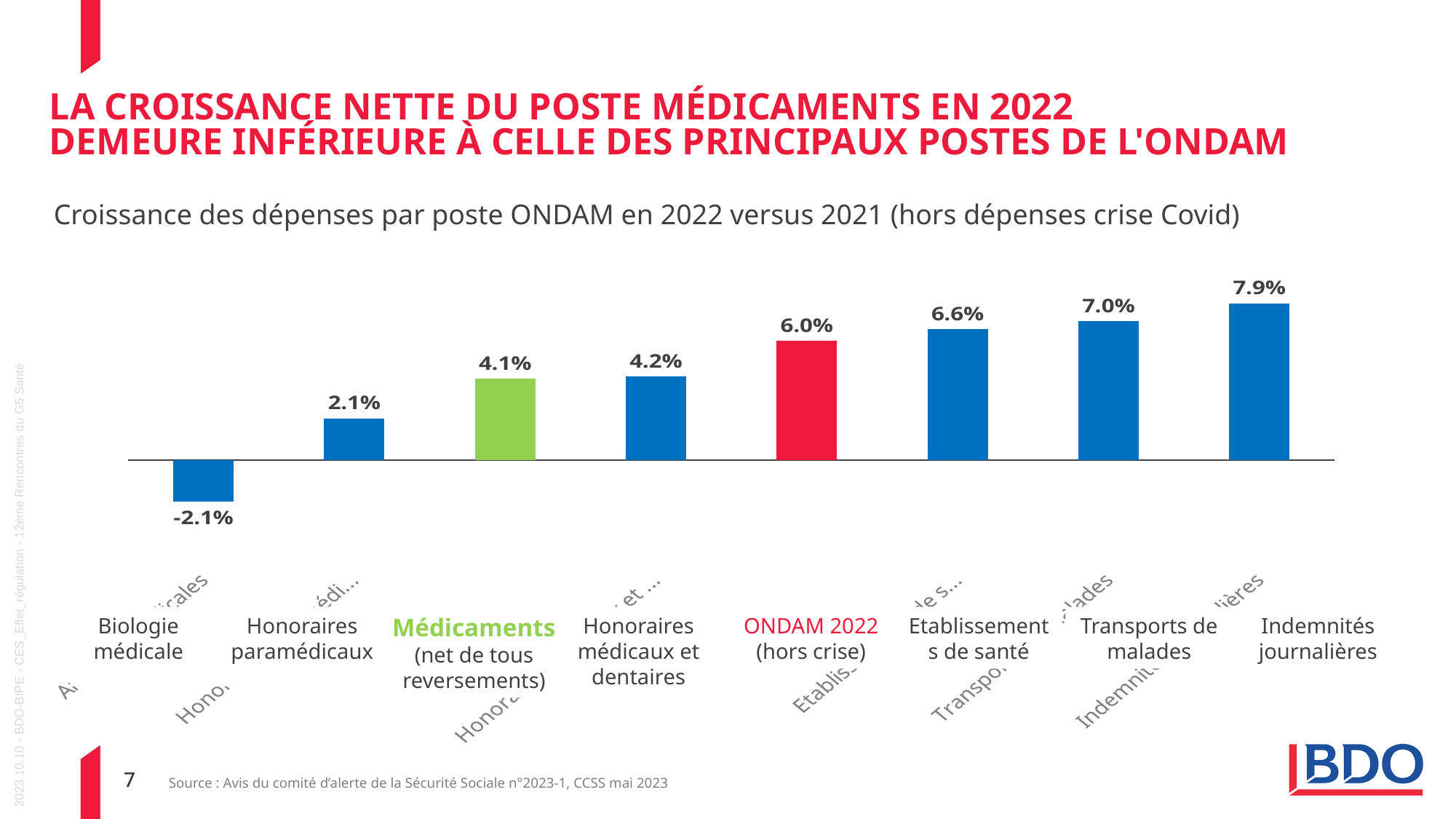
Which category has the highest growth value? Indemnités journalières How many categories are plotted in the chart? 8 Which category has the lowest growth value? Biologie médicale Which has a higher growth value, Etablissements de santé or Honoraires médicaux et dentaires? Etablissements de santé Which bar is coloured green in the chart? Médicaments (net de tous reversements) What is the difference between the growth of Indemnités journalières and that of Médicaments (net de tous reversements)? 3.8% What is the growth value shown for Biologie médicale? -2.1% What is the growth value shown for Médicaments (net de tous reversements)? 4.1% What is the difference between the growth of ONDAM 2022 (hors crise) and that of Honoraires paramédicaux? 3.9% What is the growth value shown for Transports de malades? 7.0% What is the growth value shown for ONDAM 2022 (hors crise)? 6.0% What kind of chart is shown on the slide? Bar chart